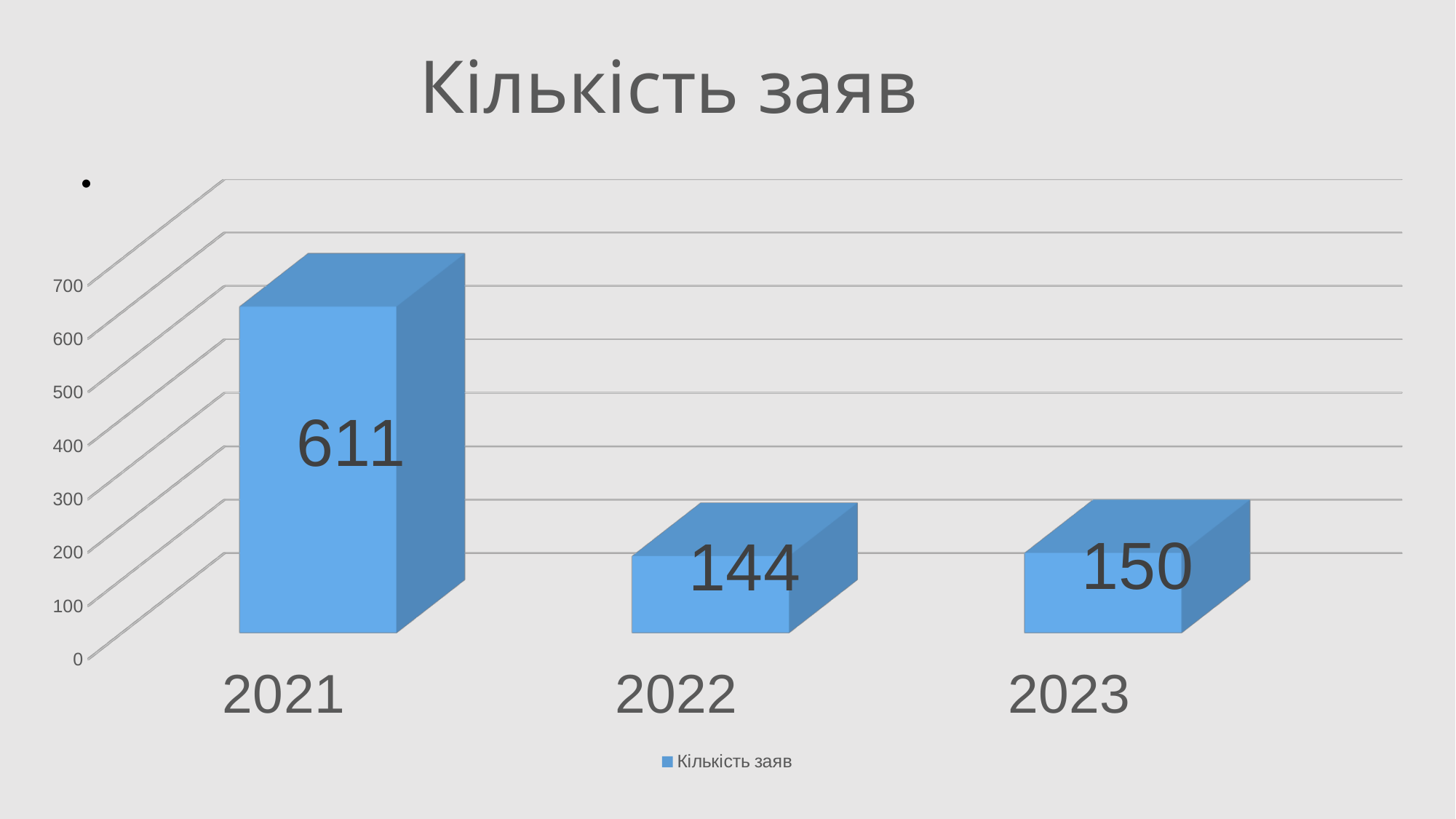
What is the difference between the values for 2023 and 2022? 6 What is the value for 2023? 150 How many series does the legend list? 1 Which year has the highest value? 2021 What is the value for 2022? 144 Which year has the lowest value? 2022 Which is larger, the value for 2021 or the value for 2023? 2021 What is the title of the chart? Кількість заяв How many years are shown on the x axis? 3 What is the value for 2021? 611 What is the difference between the values for 2021 and 2022? 467 What kind of chart is shown? bar chart